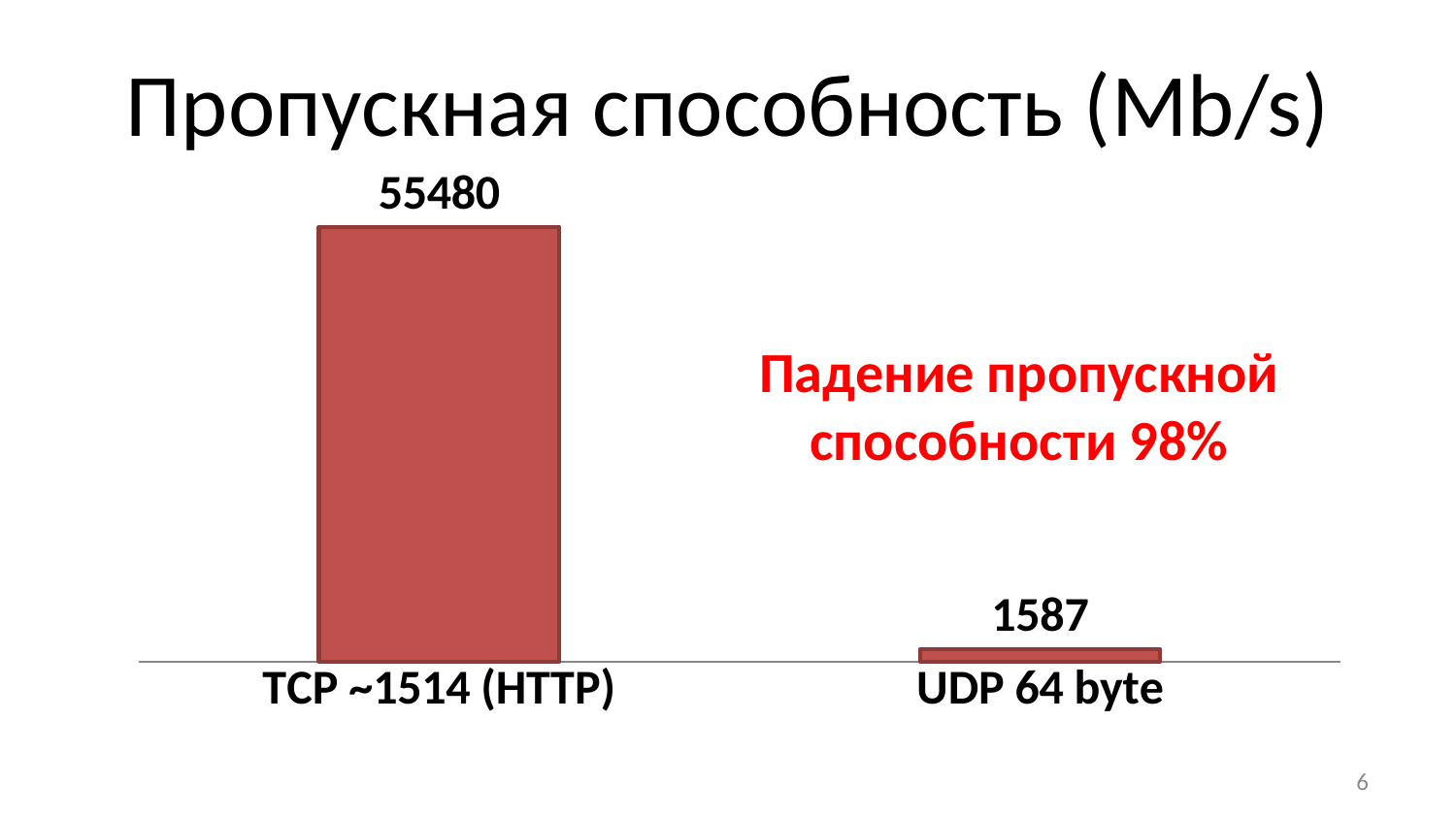
What colour are the bars in the chart? red What kind of chart is shown on the slide? bar chart How many categories are shown in the chart? 2 Which is larger, the value for TCP ~1514 (HTTP) or the value for UDP 64 byte? TCP ~1514 (HTTP) Which category has the lowest value? UDP 64 byte What is the difference between the values for TCP ~1514 (HTTP) and UDP 64 byte? 53893 What is the title of the chart? Пропускная способность (Mb/s) What is the value for UDP 64 byte? 1587 Which category has the highest value? TCP ~1514 (HTTP) What is the value for TCP ~1514 (HTTP)? 55480